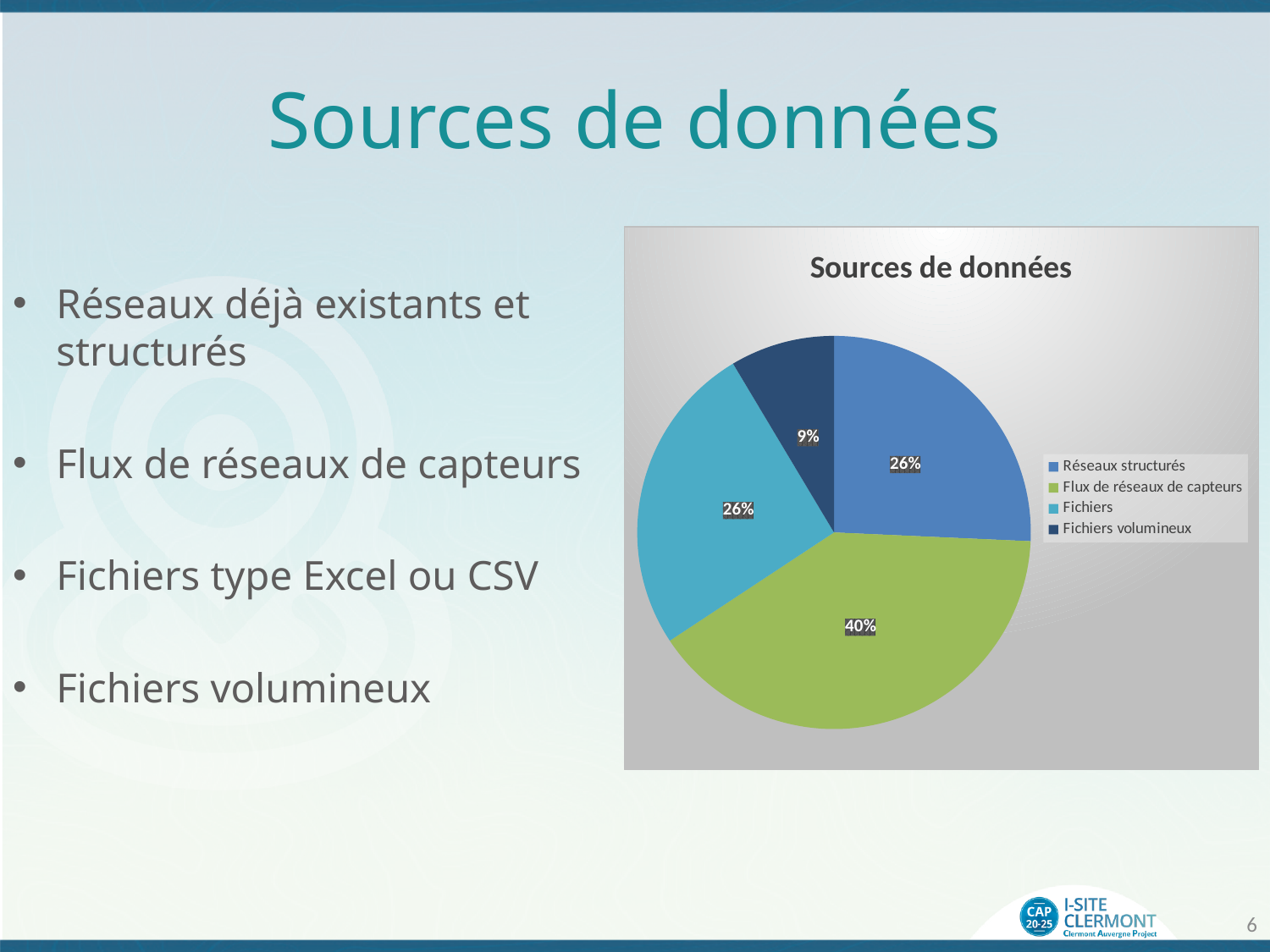
What is the difference in percentage points between 'Flux de réseaux de capteurs' and 'Fichiers volumineux'? 31% What type of chart is shown on the slide? pie chart What share of the pie does 'Fichiers' represent? 26% Which category has the largest slice of the pie? Flux de réseaux de capteurs What share of the pie does 'Fichiers volumineux' represent? 9% What is the difference in percentage points between 'Réseaux structurés' and 'Fichiers volumineux'? 17% What is the title of the chart? Sources de données How many categories does the pie chart show? 4 Which category has the smallest slice of the pie? Fichiers volumineux What share of the pie does 'Réseaux structurés' represent? 26% What share of the pie does 'Flux de réseaux de capteurs' represent? 40% Which is larger, the slice for 'Flux de réseaux de capteurs' or the slice for 'Fichiers'? Flux de réseaux de capteurs